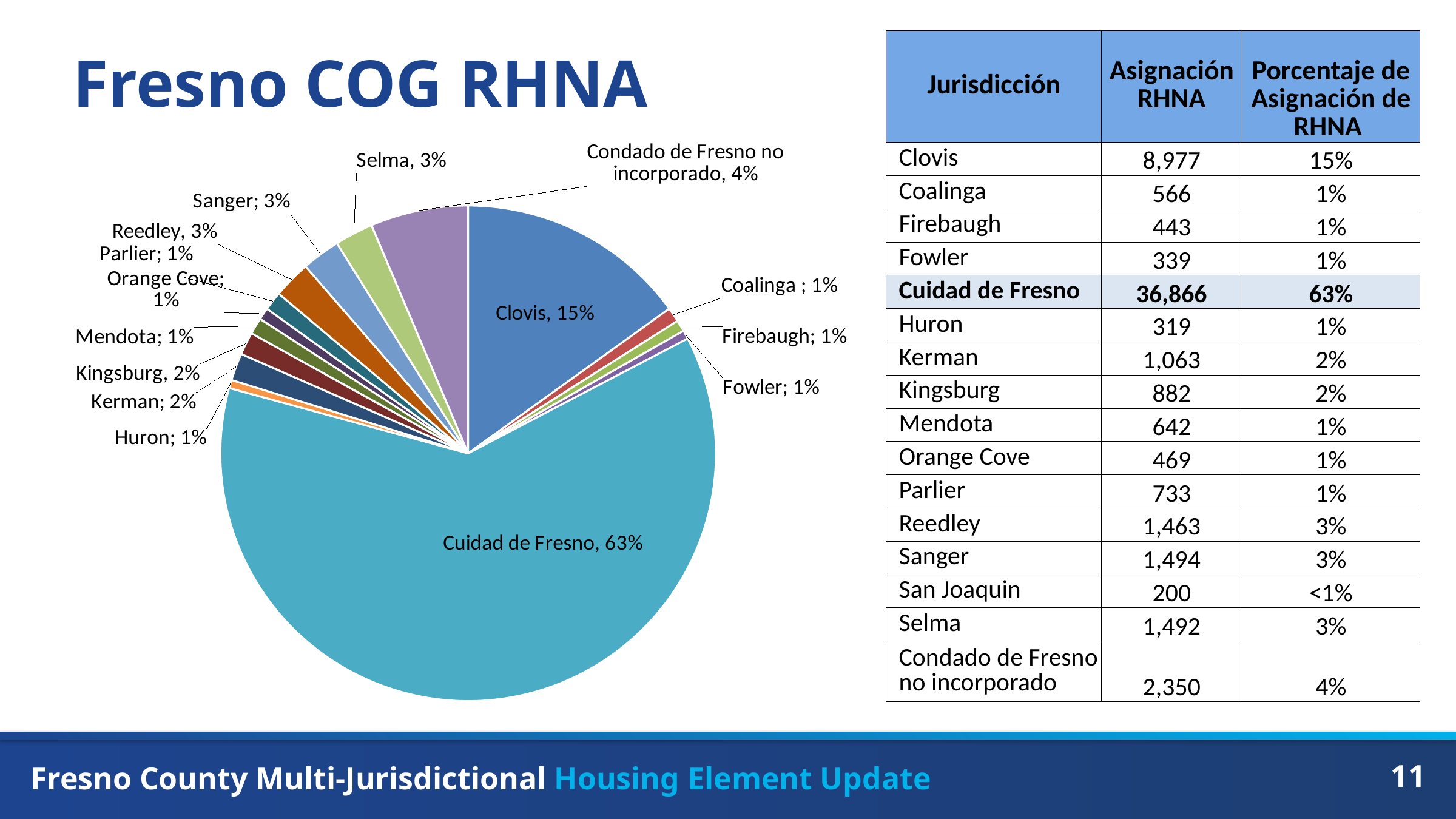
What kind of chart is shown on the slide? pie chart Which has a larger share of the pie, Clovis or Condado de Fresno no incorporado? Clovis Which jurisdiction has the largest slice of the pie chart? Cuidad de Fresno What percentage is shown for Kerman in the pie chart? 2% What share of the pie does Cuidad de Fresno hold? 63% What percentage is shown for Huron in the pie chart? 1% What is the title of the slide containing the pie chart? Fresno COG RHNA Which has a larger share of the pie, Kingsburg or Mendota? Kingsburg What percentage is shown for Selma in the pie chart? 3% What percentage is shown for Condado de Fresno no incorporado in the pie chart? 4% What is the value shown for Clovis in the pie chart? 15% What is the difference in percentage points between Cuidad de Fresno and Clovis in the pie chart? 48